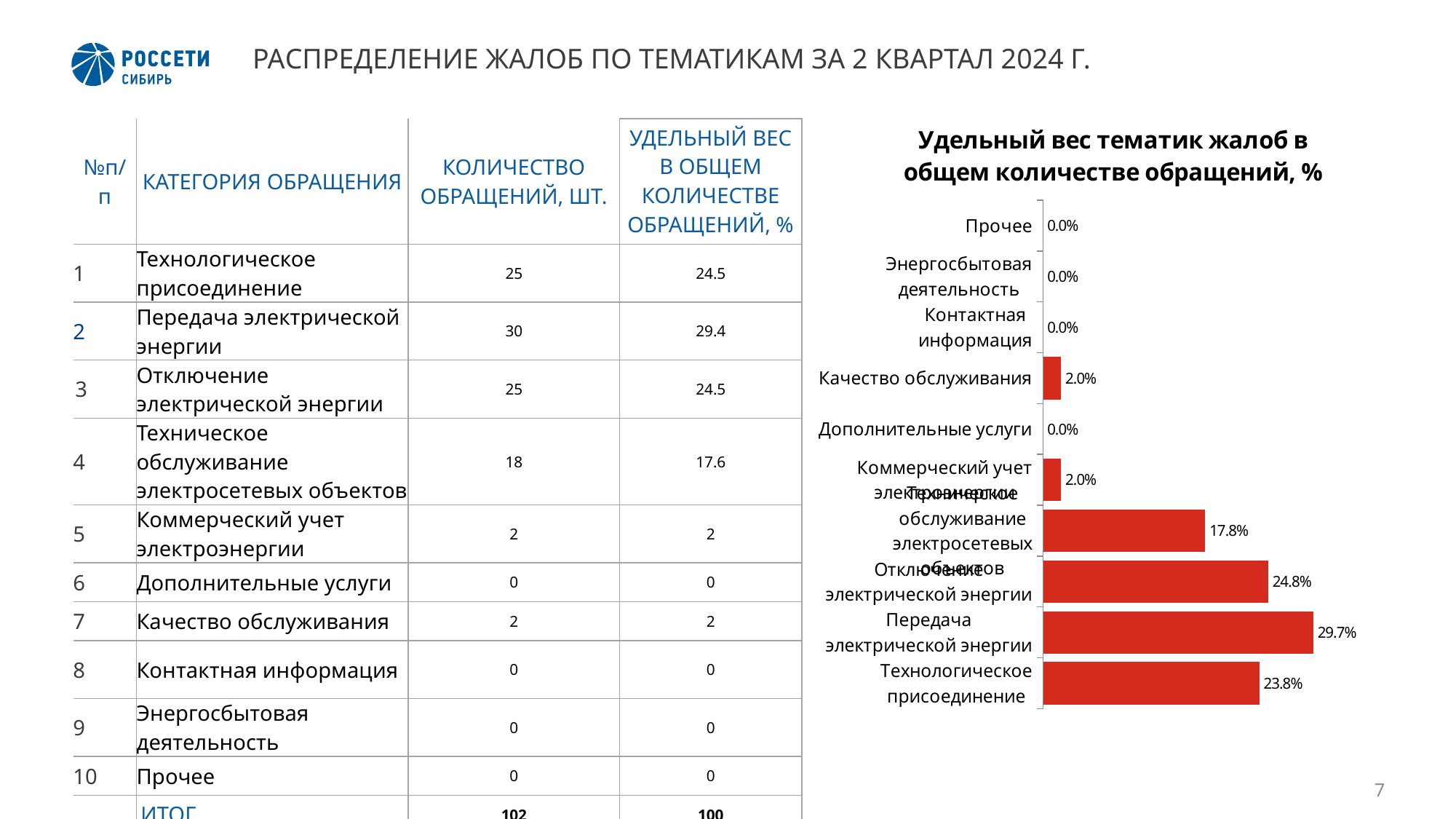
What is the chart's title? Удельный вес тематик жалоб в общем количестве обращений, % What kind of chart is shown on the slide? bar chart What is the value for Качество обслуживания in the chart? 2.0% What is the value for Технологическое присоединение in the chart? 23.8% What is the value for Передача электрической энергии in the chart? 29.7% What is the value for Техническое обслуживание электросетевых объектов in the chart? 17.8% How many categories does the chart show? 10 What is the value for Отключение электрической энергии in the chart? 24.8% Which is larger in the chart: Отключение электрической энергии or Техническое обслуживание электросетевых объектов? Отключение электрической энергии Which category has the highest value in the chart? Передача электрической энергии What colour are the bars in the chart? red What is the difference between the values for Передача электрической энергии and Технологическое присоединение in the chart? 5.9%